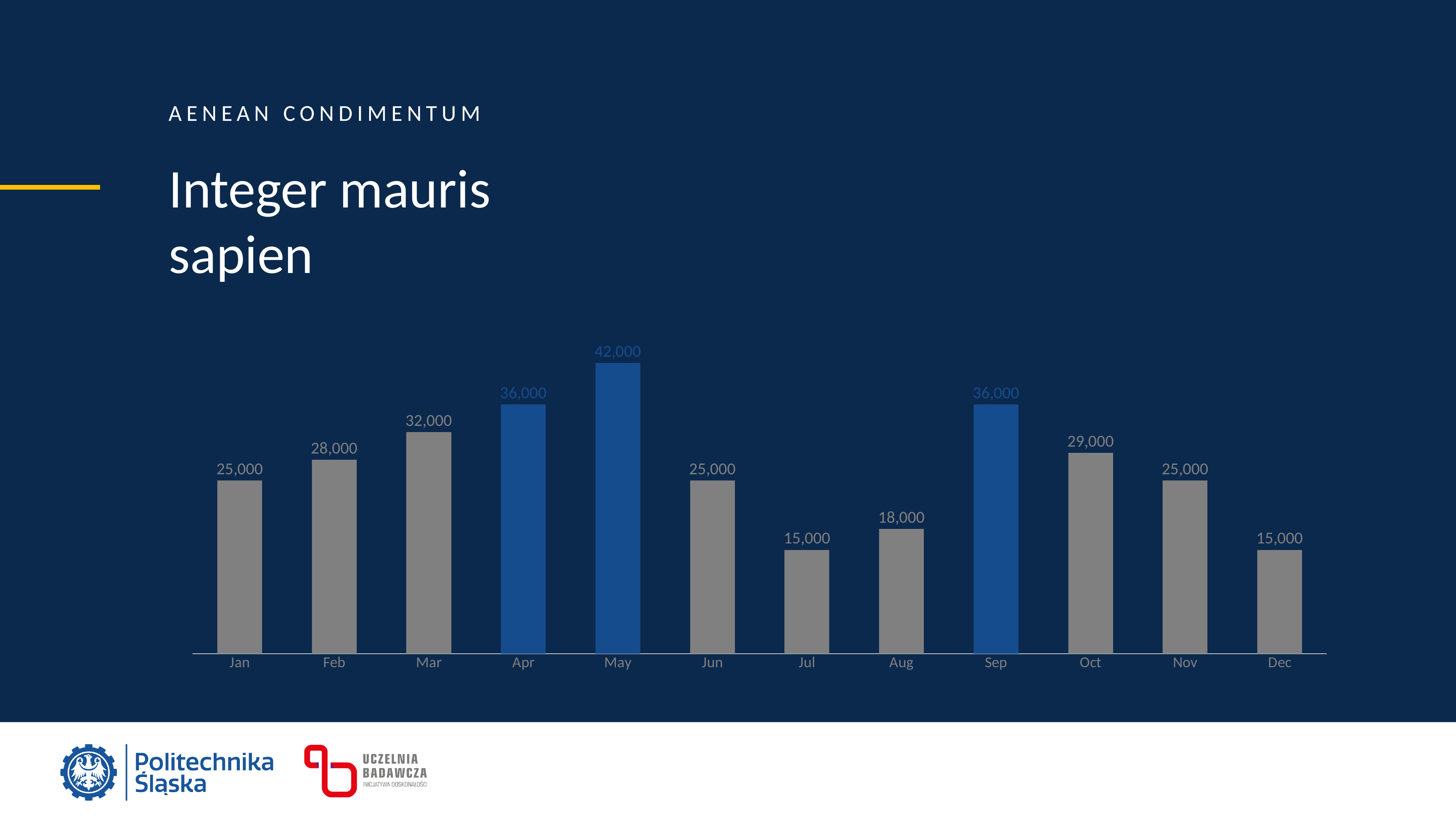
What is the difference between the values for May and Jan? 17,000 What is the value for May? 42,000 How many months are shown on the x axis? 12 What is the difference between the values for Mar and Feb? 4,000 Do the values rise or fall from Jan to May? Rise What is the value for Oct? 29,000 Which month has the highest value? May Which is larger, the value for Oct or the value for Nov? Oct What kind of chart is shown on the slide? Bar chart Which is larger, the value for Jul or the value for Aug? Aug What is the value for Aug? 18,000 Which months have bars highlighted in blue? Apr, May, Sep